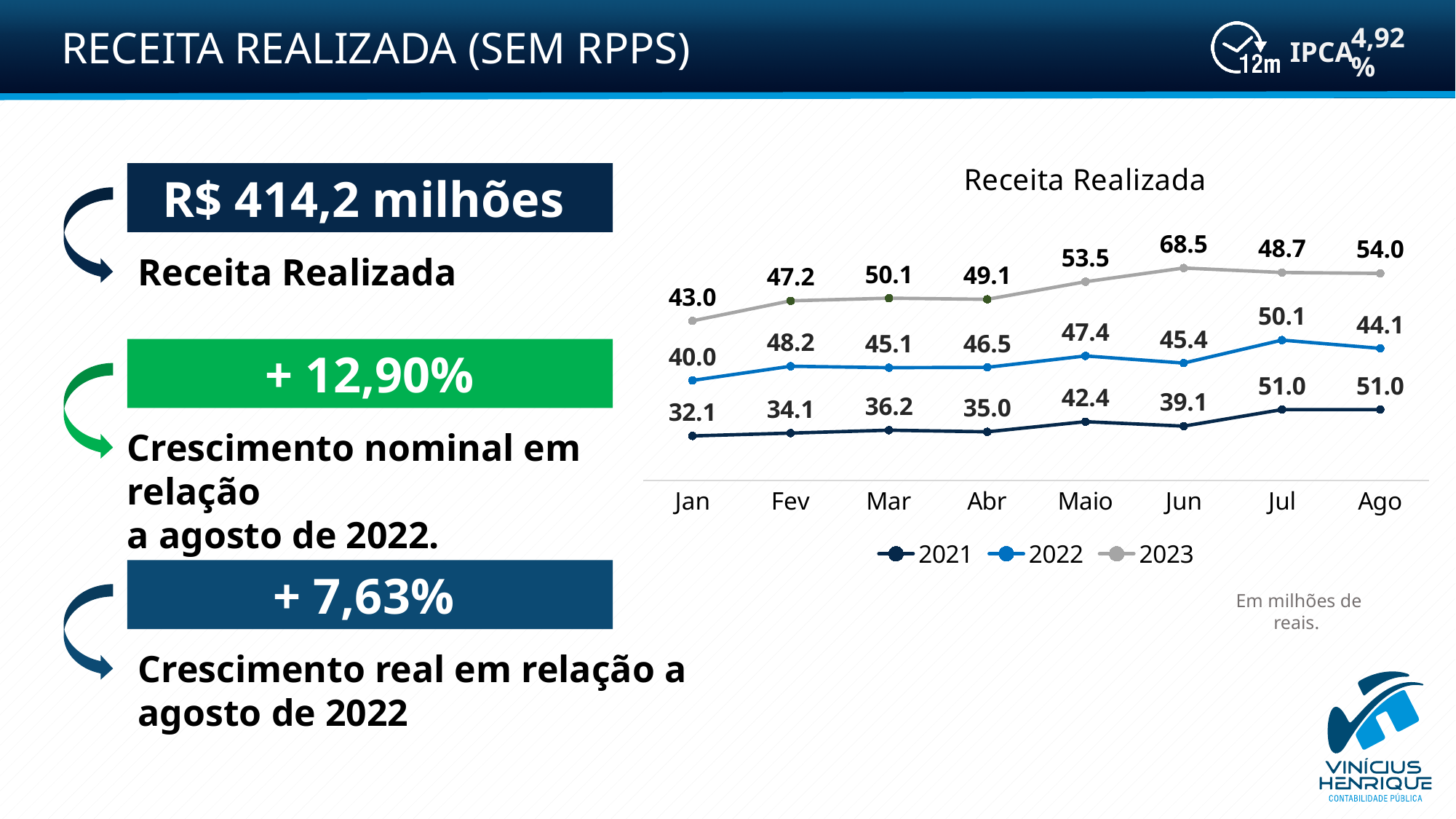
What is the value for 2023 in Jun? 68.5 In which month is the 2021 series at its lowest value? Jan What is the title of the chart? Receita Realizada What is the value for 2022 in Jul? 50.1 What is the value for 2021 in Jan? 32.1 Does the 2021 series rise or fall from Jan to Ago overall? rise In which month does the 2023 series reach its highest value? Jun Which is larger in Jul: the 2021 value or the 2022 value? 2021 How many months are shown on the x axis? 8 How many series does the legend list? 3 What is the difference between the 2023 and 2022 values in Ago? 9.9 What kind of chart is shown? line chart